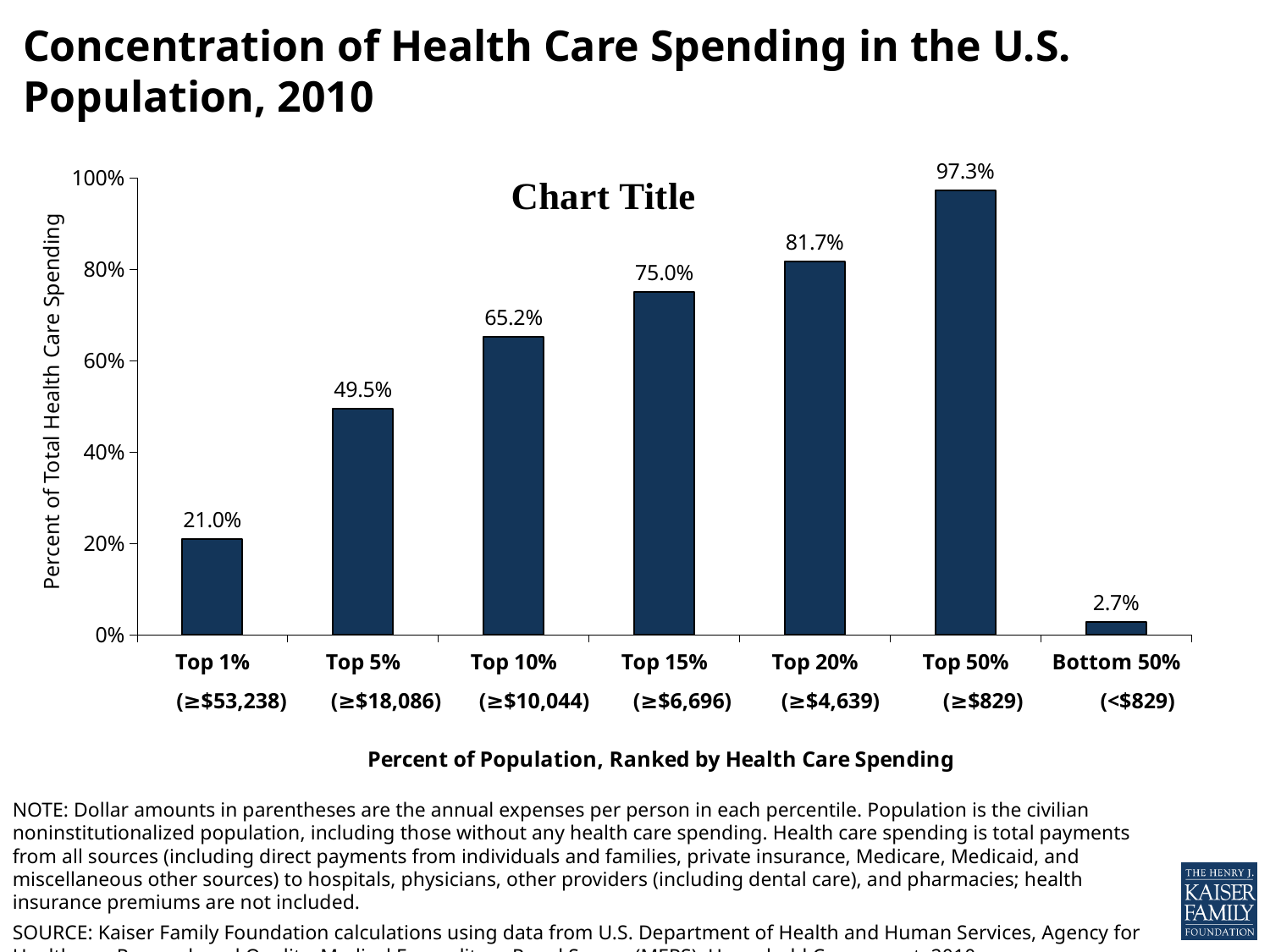
Which category has the lowest percent of total health care spending? Bottom 50% Which is larger, the value for Top 5% or the value for Top 10%? Top 10% Do the values rise or fall from Top 1% through Top 50%? Rise What percent of total health care spending does the Bottom 50% account for? 2.7% Which category has the highest percent of total health care spending? Top 50% What is the value shown for the Top 10% category? 65.2% What kind of chart is shown on the slide? Bar chart How many categories are shown on the x axis? 7 What is the difference between the values for Top 20% and Top 15%? 6.7% What percent of total health care spending is attributed to the Top 1% of the population? 21.0% Is the value for Top 5% greater or less than 40%? greater What is the label of the y axis? Percent of Total Health Care Spending